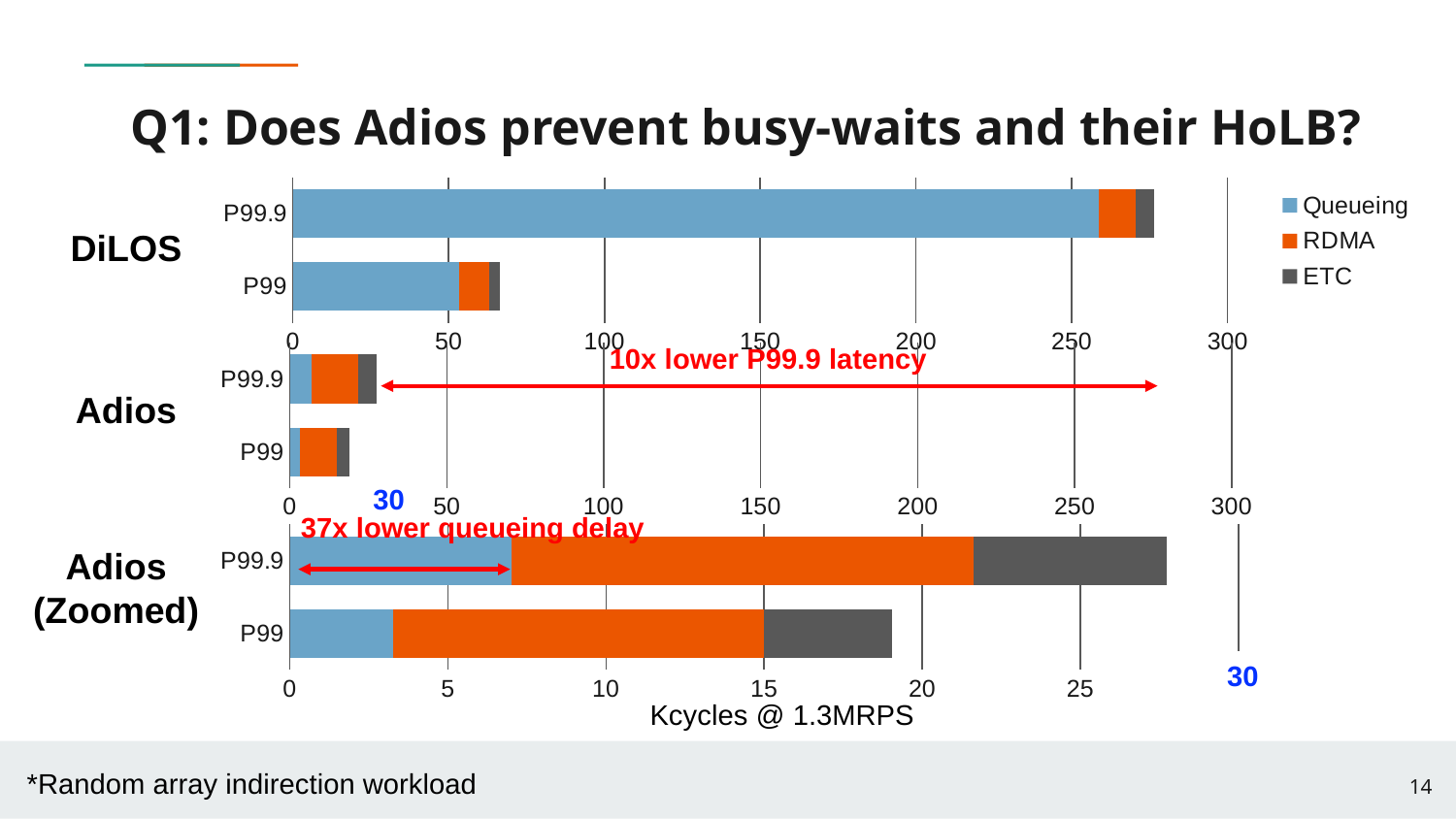
How many series does the legend list? 3 In the Adios (Zoomed) chart, which category has the shorter bar? P99 In the DiLOS chart, which category has the longer bar, P99.9 or P99? P99.9 What are the three series named in the legend? Queueing, RDMA, ETC In the Adios (Zoomed) chart, is the total length of the P99.9 bar greater or less than 25? greater In the DiLOS chart, is the total length of the P99 bar greater or less than 100? less In the Adios chart (middle panel), is the total length of the P99.9 bar greater or less than 50? less What kind of chart is used for the DiLOS panel at the top of the slide? Stacked bar chart What is the x-axis label shown under the Adios (Zoomed) chart? Kcycles @ 1.3MRPS How many categories (bars) are plotted in the Adios (Zoomed) chart? 2